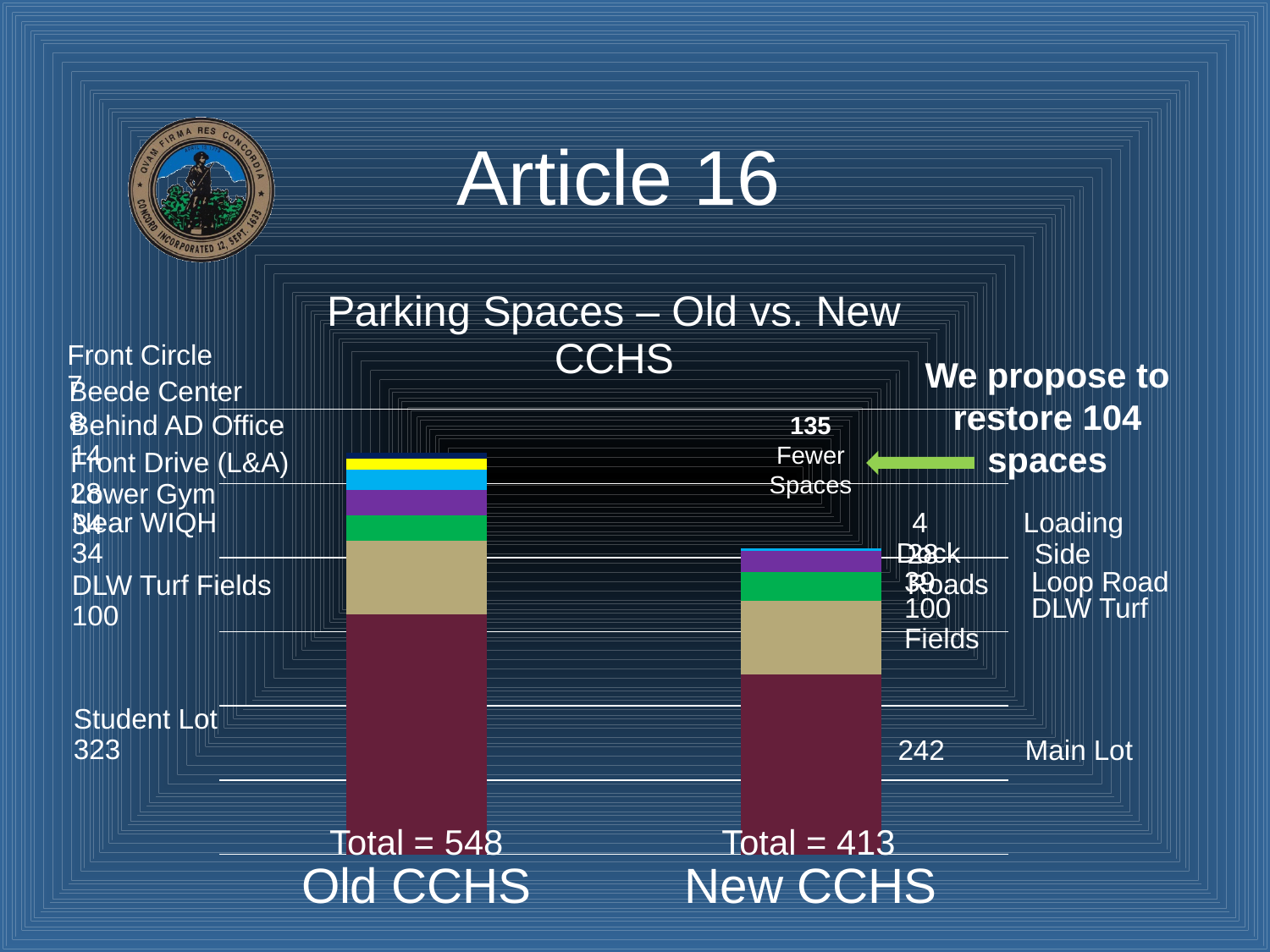
How many spaces are in the Main Lot at New CCHS? 242 How many bars does the chart have? 2 How many spaces are in the DLW Turf Fields at Old CCHS? 100 What is the title of the chart? Parking Spaces – Old vs. New CCHS Which has more total parking spaces, Old CCHS or New CCHS? Old CCHS What is the total number of parking spaces for New CCHS? 413 What is the difference between the Old CCHS Student Lot and the New CCHS Main Lot? 81 How many fewer parking spaces does New CCHS have compared to Old CCHS? 135 How many spaces does the slide propose to restore? 104 How many spaces are in the Student Lot at Old CCHS? 323 What is the total number of parking spaces for Old CCHS? 548 What kind of chart is shown on the slide? stacked bar chart